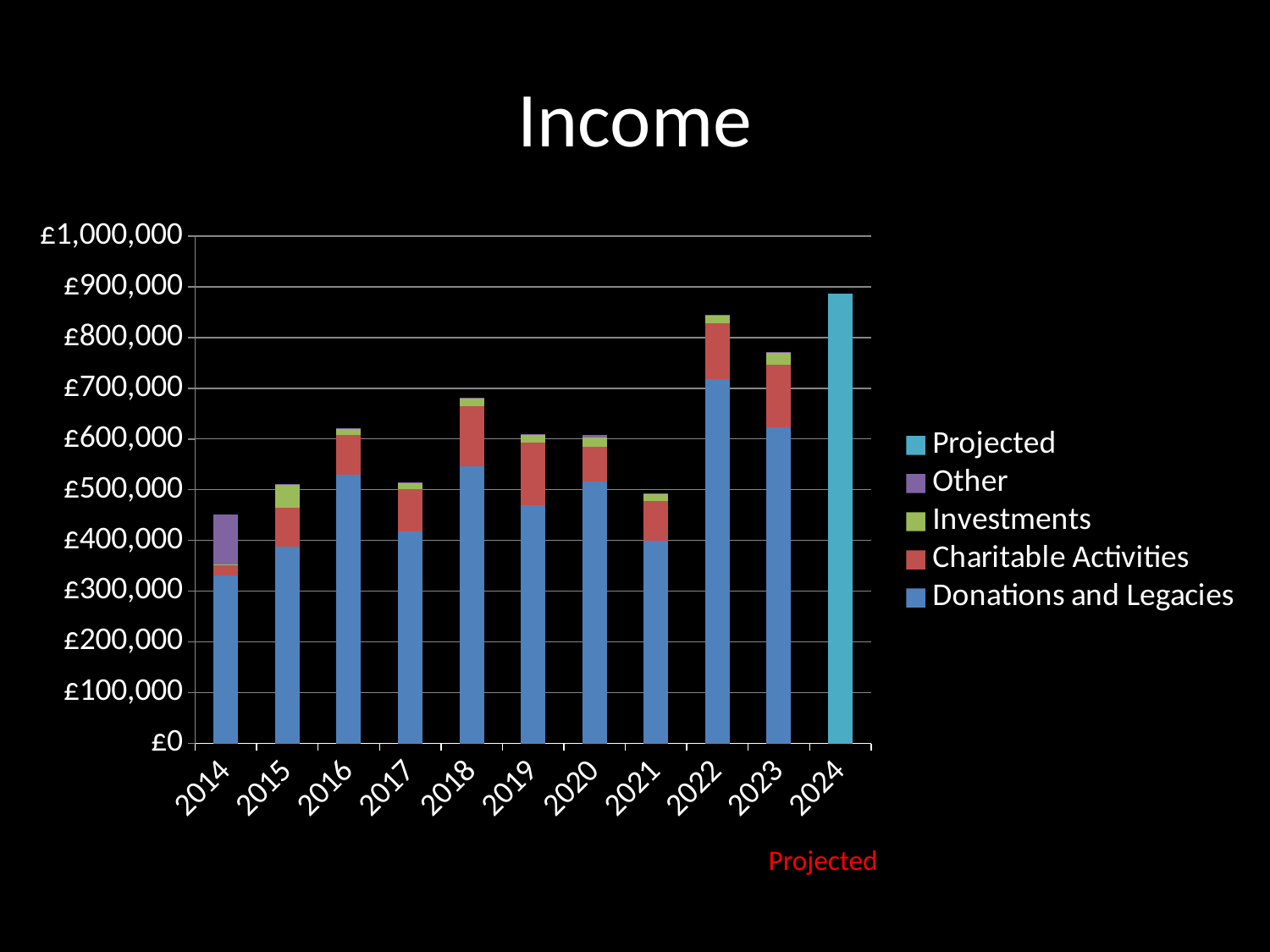
Is the total income for 2022 greater or less than £800,000? greater Is the total income for 2018 greater or less than £600,000? greater Is the total income for 2014 greater or less than £500,000? less How many years are shown on the x axis? 11 Which year has the larger total income, 2022 or 2023? 2022 Which year has the shortest bar overall? 2014 What is the title of the chart? Income How many series does the legend list? 5 Which year has the tallest bar overall? 2024 What kind of chart is shown on the slide? Stacked bar chart